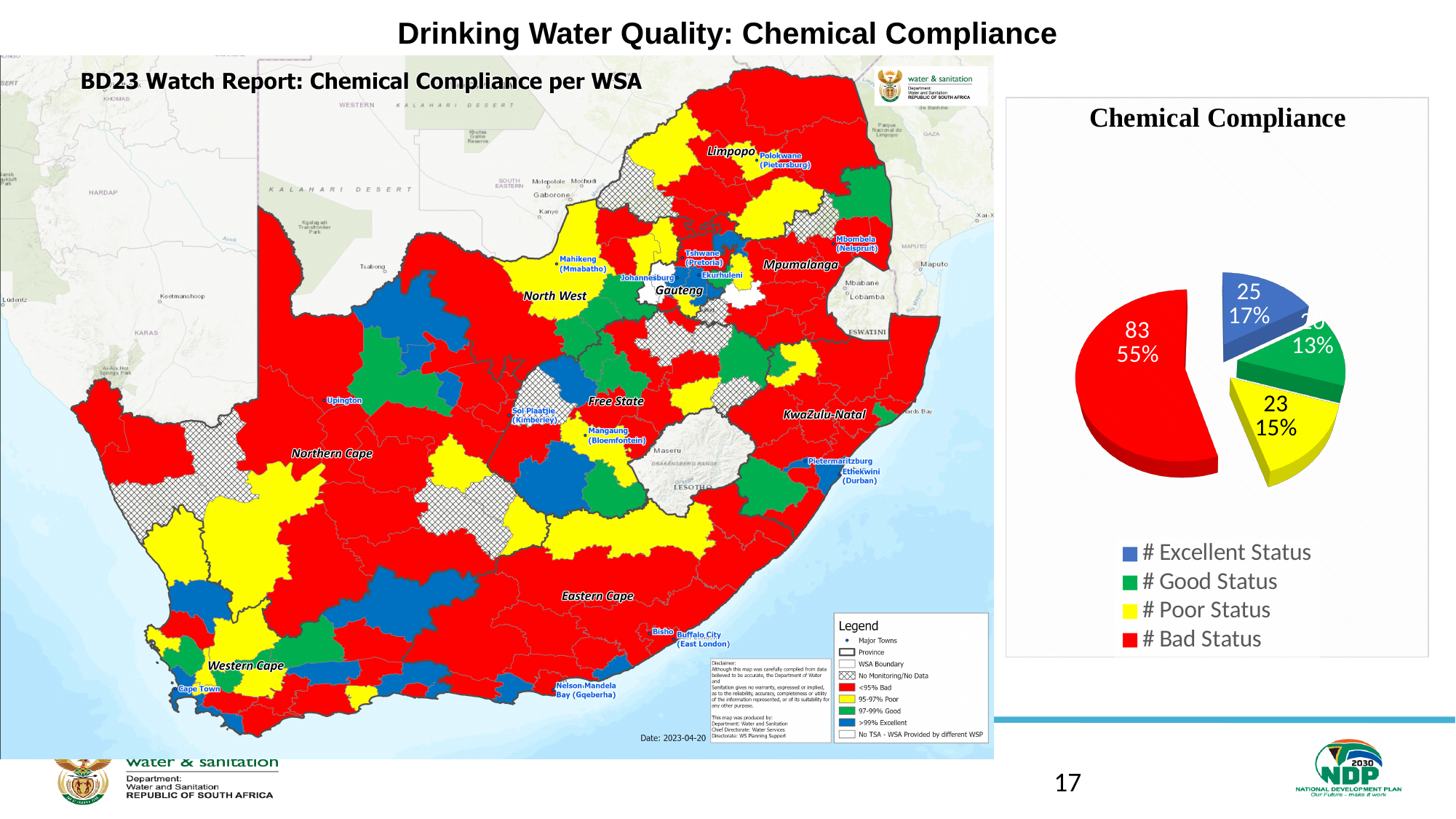
In the 'Chemical Compliance' pie chart, what percentage share does Excellent Status have? 17% What kind of chart is the 'Chemical Compliance' chart on the right of the slide? pie chart In the 'Chemical Compliance' pie chart, which is larger: the Excellent Status count or the Poor Status count? Excellent Status In the 'Chemical Compliance' pie chart, how many WSAs are in Poor Status? 23 In the 'Chemical Compliance' pie chart, which status category has the largest slice? # Bad Status In the 'Chemical Compliance' pie chart, how many WSAs are in Bad Status? 83 In the 'Chemical Compliance' pie chart, which status category has the smallest slice? # Good Status How many categories does the legend of the 'Chemical Compliance' pie chart list? 4 In the 'Chemical Compliance' pie chart, what percentage share does Bad Status have? 55% In the 'Chemical Compliance' pie chart, how many WSAs are in Excellent Status? 25 In the 'Chemical Compliance' pie chart, what is the difference between the number of WSAs in Bad Status and in Excellent Status? 58 In the 'Chemical Compliance' pie chart, what percentage share does Good Status have? 13%